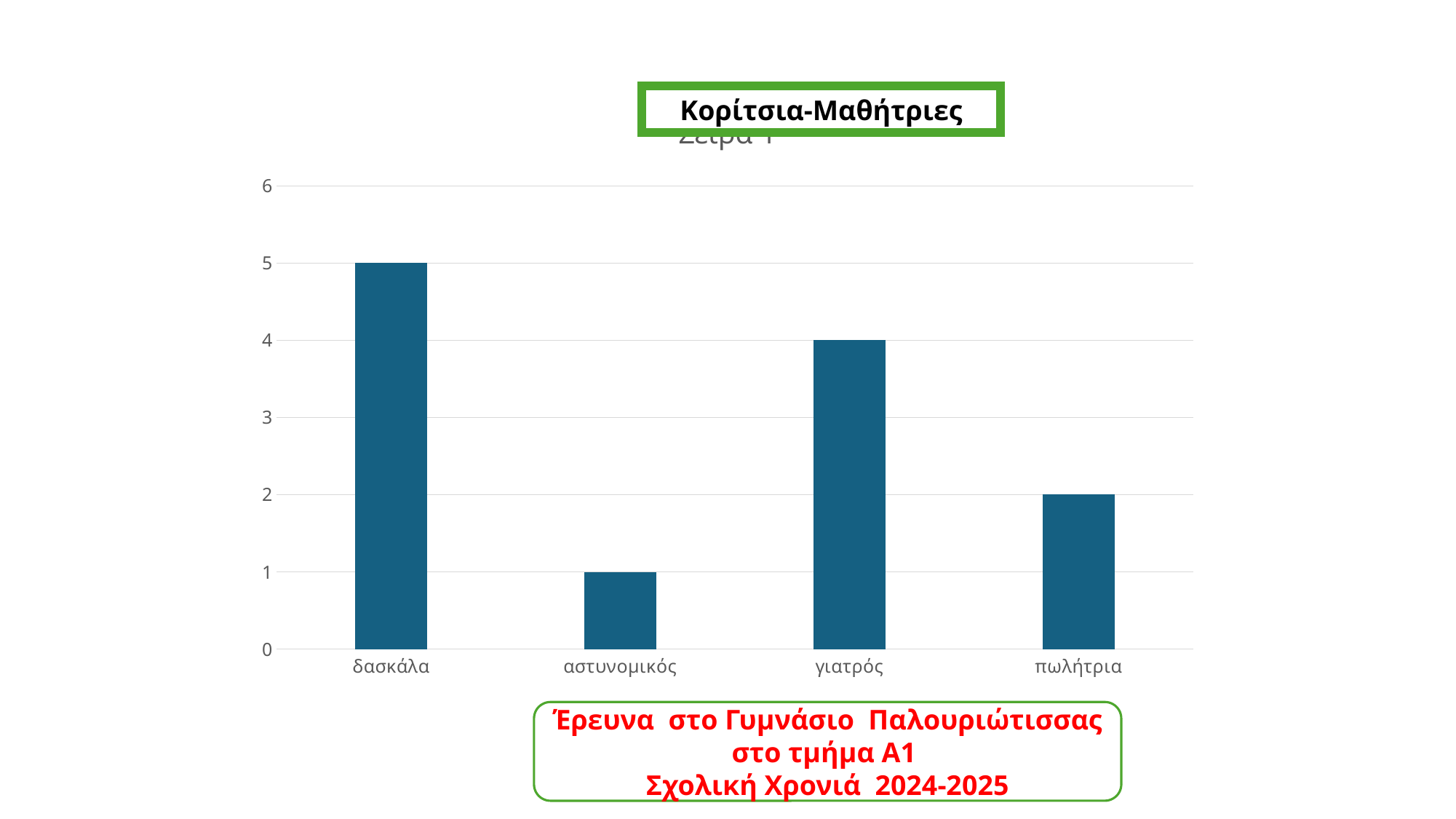
Which is larger, the value for γιατρός or the value for πωλήτρια? γιατρός What is the difference between the values for δασκάλα and γιατρός? 1 Which category has the highest value? δασκάλα What is the value for πωλήτρια? 2 Which category has the lowest value? αστυνομικός What is the value for αστυνομικός? 1 Is the value for πωλήτρια greater or less than 3? less What kind of chart is shown on the slide? bar chart What is the value for γιατρός? 4 What text is shown in the green-bordered box above the chart? Κορίτσια-Μαθήτριες What is the value for δασκάλα? 5 How many categories are shown on the x axis of the chart? 4